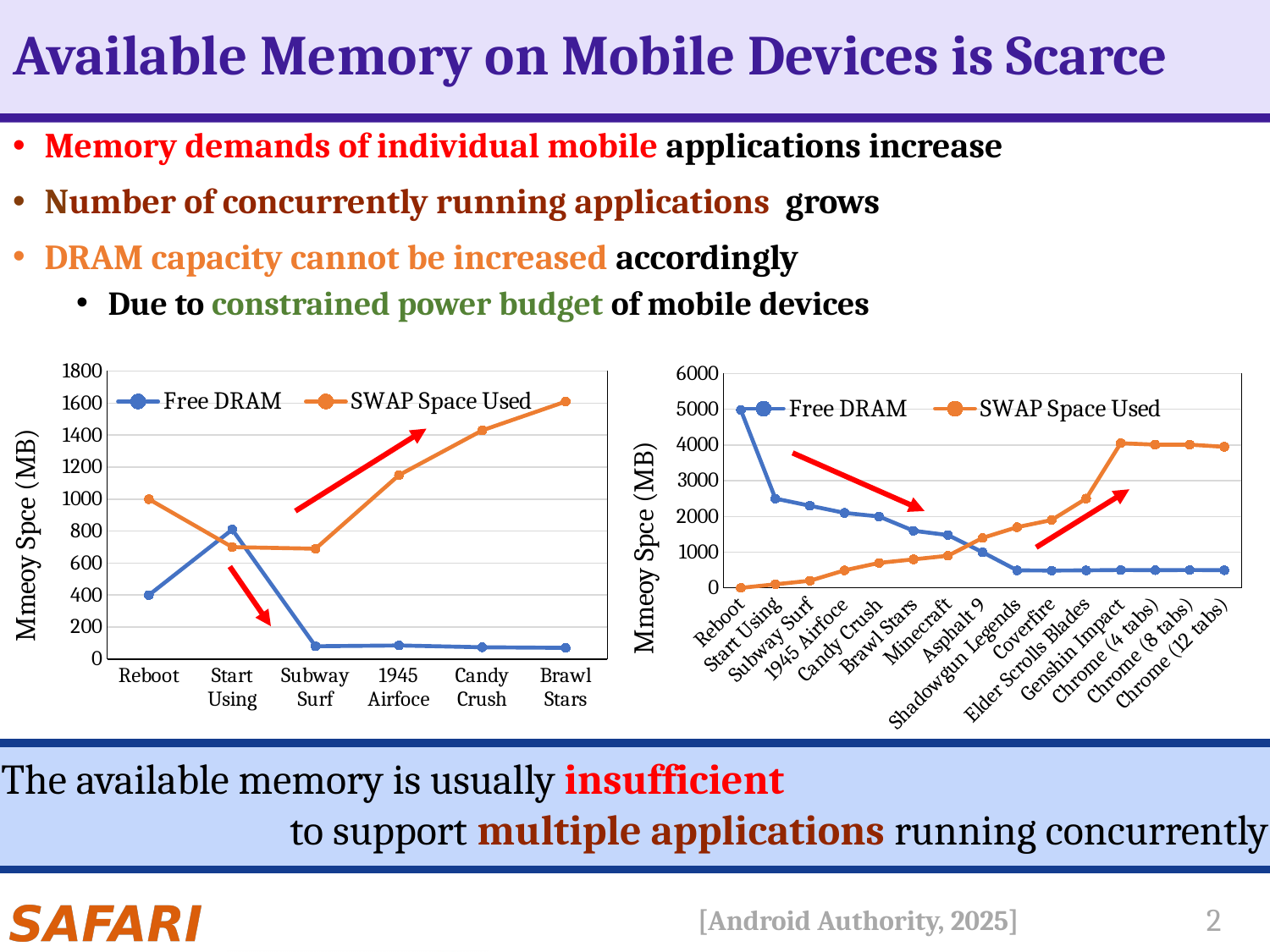
In the right chart, which category has the lowest SWAP Space Used value? Reboot In the left chart, is the SWAP Space Used value for Brawl Stars greater or less than 1400? greater In the left chart, which category has the highest SWAP Space Used value? Brawl Stars In the right chart, does the Free DRAM series generally rise or fall from Reboot to Chrome (12 tabs)? fall How many categories are shown on the x axis of the right chart? 15 In the right chart, which is larger at Genshin Impact: Free DRAM or SWAP Space Used? SWAP Space Used In the right chart, is the Free DRAM value for Reboot greater or less than 4000? greater In the left chart, which category has the highest Free DRAM value? Start Using In the left chart, is the Free DRAM value for Subway Surf greater or less than 200? less How many series does the legend of the right chart list? 2 What kind of chart is the left chart? line chart How many categories are shown on the x axis of the left chart? 6